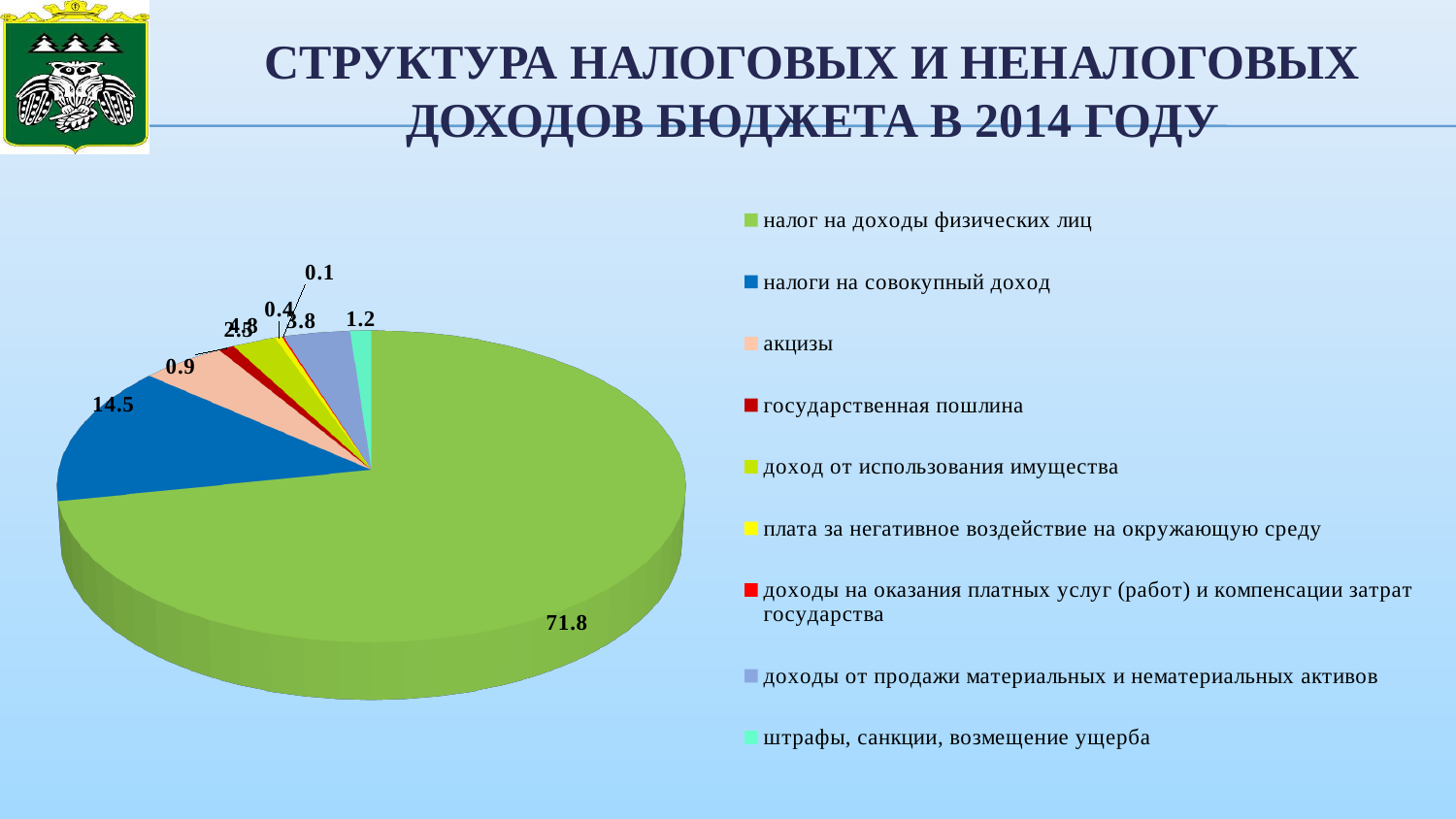
What is the difference between the values for налог на доходы физических лиц and налоги на совокупный доход? 57.3 What share of the pie does налог на доходы физических лиц take? 71.8 How many categories does the legend of the pie chart list? 9 What is the value shown for штрафы, санкции, возмещение ущерба? 1.2 Which is larger: the slice for налоги на совокупный доход or the slice for доходы от продажи материальных и нематериальных активов? налоги на совокупный доход What is the value shown for доходы от продажи материальных и нематериальных активов? 3.8 Which category has the largest slice of the pie? налог на доходы физических лиц What kind of chart is shown on the slide? pie chart What is the value shown for налог на доходы физических лиц? 71.8 Which category has the smallest slice of the pie? доходы на оказания платных услуг (работ) и компенсации затрат государства What is the value shown for налоги на совокупный доход? 14.5 Which year does the chart title say the budget income structure refers to? 2014